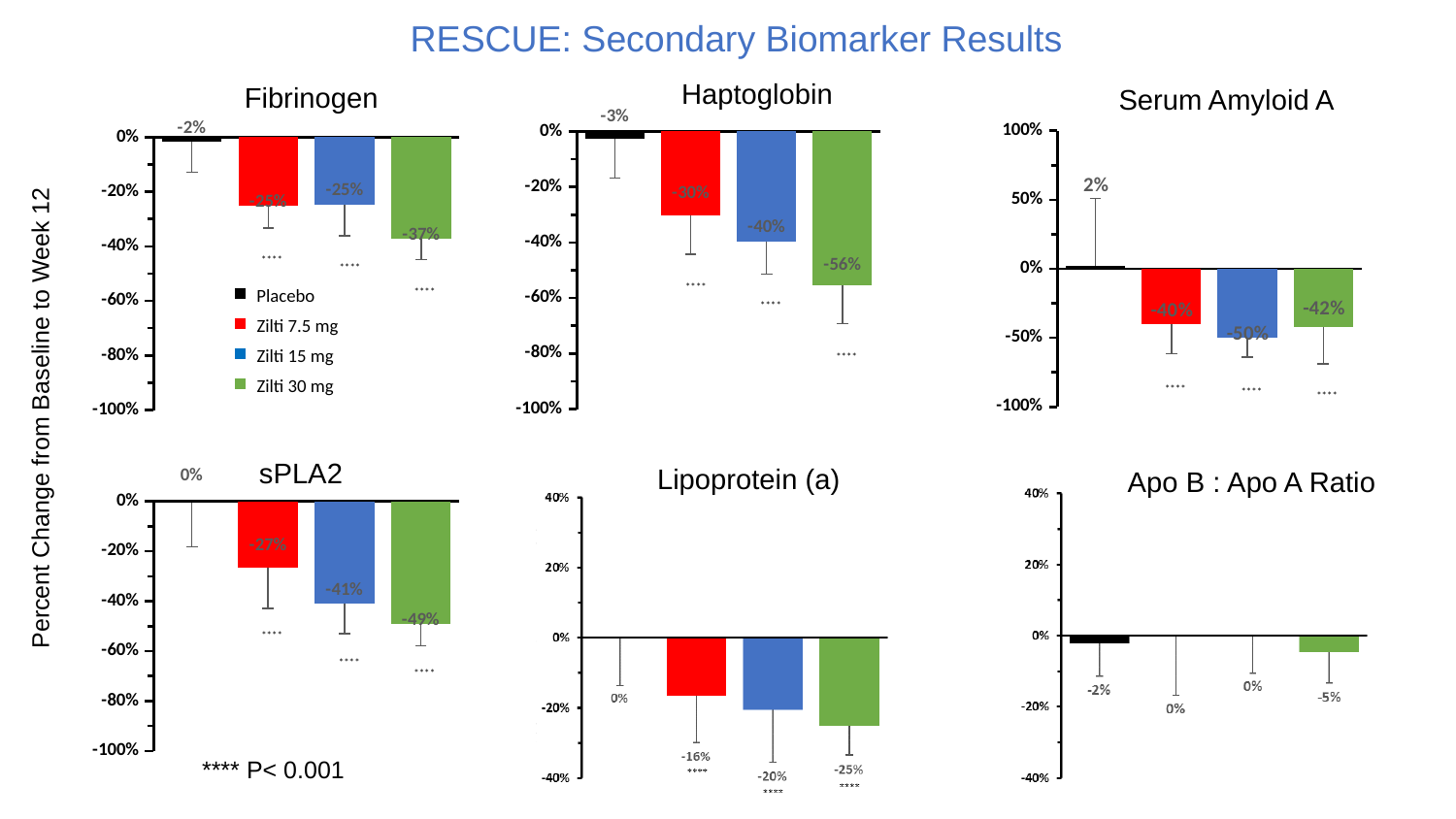
In the Apo B : Apo A Ratio chart, what is the percent change for Zilti 30 mg? -5% In the Lipoprotein (a) chart, what is the percent change for Zilti 30 mg? -25% In the sPLA2 chart, what is the percent change for Zilti 7.5 mg? -27% In the Haptoglobin chart, what is the percent change for Zilti 15 mg? -40% What type of chart is used for the Haptoglobin results? Bar chart In the Serum Amyloid A chart, what is the percent change for Placebo? 2% In the sPLA2 chart, what is the difference between the Zilti 30 mg and Zilti 7.5 mg percent changes? 22 percentage points How many series does the legend on the Fibrinogen chart list? 4 In the Haptoglobin chart, which group shows the largest reduction? Zilti 30 mg In the Lipoprotein (a) chart, is the reduction for Zilti 15 mg larger than for Zilti 7.5 mg? Yes In the Fibrinogen chart, what is the percent change for Zilti 30 mg? -37% In the Serum Amyloid A chart, which group shows the largest reduction? Zilti 15 mg